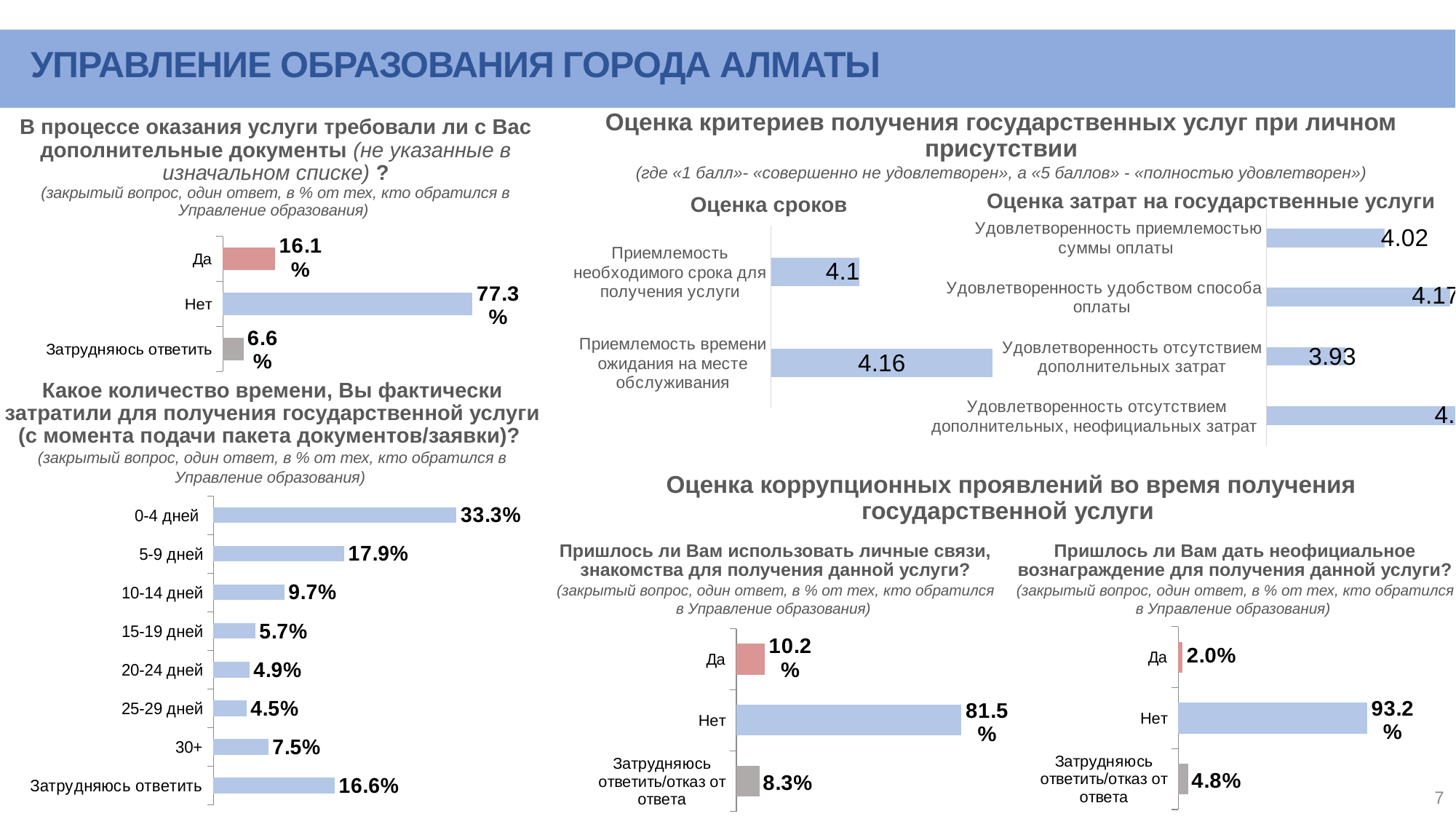
In the chart 'В процессе оказания услуги требовали ли с Вас дополнительные документы', what is the value for 'Нет'? 77.3% In the chart 'В процессе оказания услуги требовали ли с Вас дополнительные документы', what is the difference between 'Да' and 'Затрудняюсь ответить'? 9.5% What type of chart is 'Пришлось ли Вам дать неофициальное вознаграждение для получения данной услуги?'? Bar chart In the chart 'Какое количество времени, Вы фактически затратили для получения государственной услуги', how many categories are shown? 8 In the chart 'Оценка затрат на государственные услуги', what is the value for 'Удовлетворенность отсутствием дополнительных затрат'? 3.93 In the chart 'Пришлось ли Вам дать неофициальное вознаграждение для получения данной услуги?', what is the value for 'Нет'? 93.2% In the chart 'Какое количество времени, Вы фактически затратили для получения государственной услуги', what is the value for '30+'? 7.5% In the chart 'Какое количество времени, Вы фактически затратили для получения государственной услуги', which category has the lowest value? 25-29 дней In the chart 'Оценка сроков', what is the value for 'Приемлемость времени ожидания на месте обслуживания'? 4.16 In the chart 'Пришлось ли Вам использовать личные связи, знакомства для получения данной услуги?', what is the value for 'Да'? 10.2% In the chart 'Оценка затрат на государственные услуги', which is larger: 'Удовлетворенность приемлемостью суммы оплаты' or 'Удовлетворенность удобством способа оплаты'? Удовлетворенность удобством способа оплаты In the chart 'Какое количество времени, Вы фактически затратили для получения государственной услуги', which category has the highest value? 0-4 дней